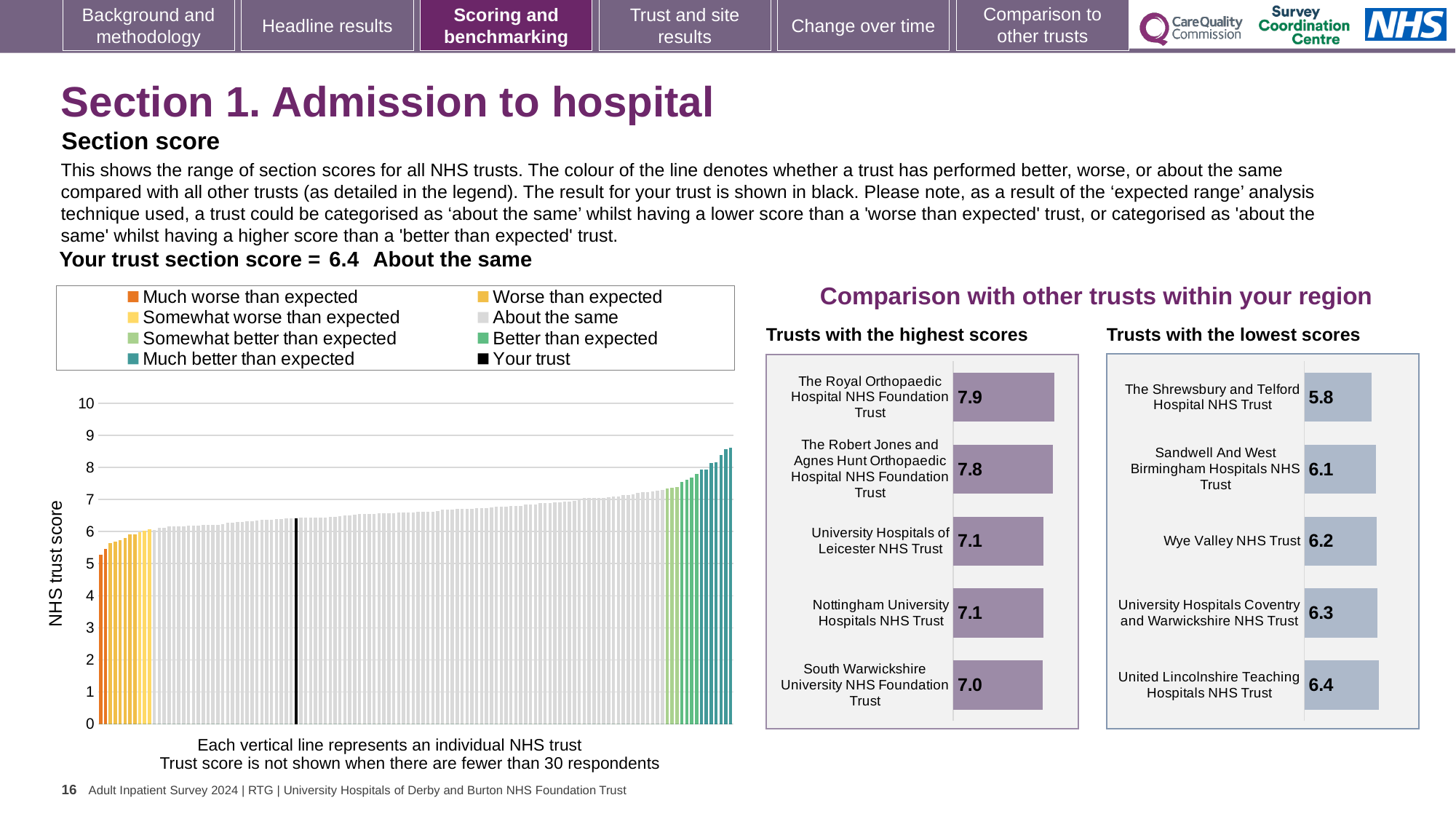
In the 'Trusts with the highest scores' chart, what is the score for The Royal Orthopaedic Hospital NHS Foundation Trust? 7.9 How many entries does the legend of the large chart on the left list? 8 In the 'Trusts with the highest scores' chart, what is the score for South Warwickshire University NHS Foundation Trust? 7.0 In the 'Trusts with the lowest scores' chart, which has the larger score: Wye Valley NHS Trust or Sandwell And West Birmingham Hospitals NHS Trust? Wye Valley NHS Trust In the large chart on the left showing all NHS trusts, is the value of the tallest bar greater or less than 8? greater What kind of chart is the 'Trusts with the lowest scores' chart? bar chart In the 'Trusts with the lowest scores' chart, which trust has the highest score? United Lincolnshire Teaching Hospitals NHS Trust In the 'Trusts with the lowest scores' chart, what is the score for The Shrewsbury and Telford Hospital NHS Trust? 5.8 In the 'Trusts with the highest scores' chart, what is the difference between the scores of The Royal Orthopaedic Hospital NHS Foundation Trust and South Warwickshire University NHS Foundation Trust? 0.9 In the 'Trusts with the lowest scores' chart, which trust has the lowest score? The Shrewsbury and Telford Hospital NHS Trust In the large chart on the left showing all NHS trusts, do the bar values rise or fall from left to right? rise How many trusts are shown in the 'Trusts with the highest scores' chart? 5